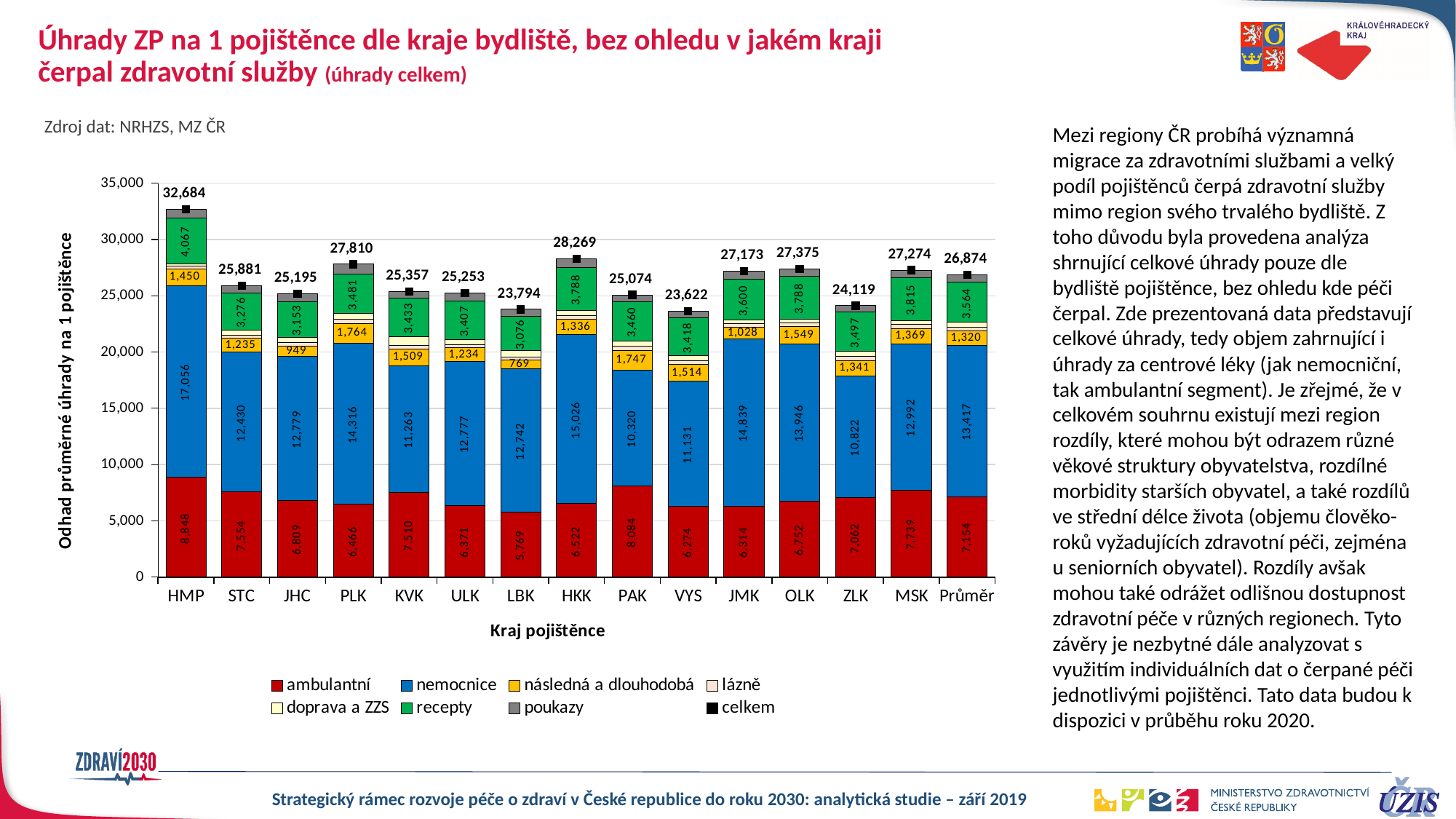
What is the total (celkem) value for HMP? 32,684 What kind of chart is shown on the slide? stacked bar chart What is the ambulantní value for PAK? 8,084 Is the total value for LBK greater or less than 25,000? less How many entries does the legend list? 8 Which region has the lowest total (celkem) value? VYS What is the nemocnice value for HKK? 15,026 Which region has the highest total (celkem) value? HMP Which is larger, the nemocnice value for JMK or the nemocnice value for OLK? JMK How many categories are shown on the x axis? 15 What is the difference between the total for HKK and the total for PLK? 459 What is the recepty value for MSK? 3,815